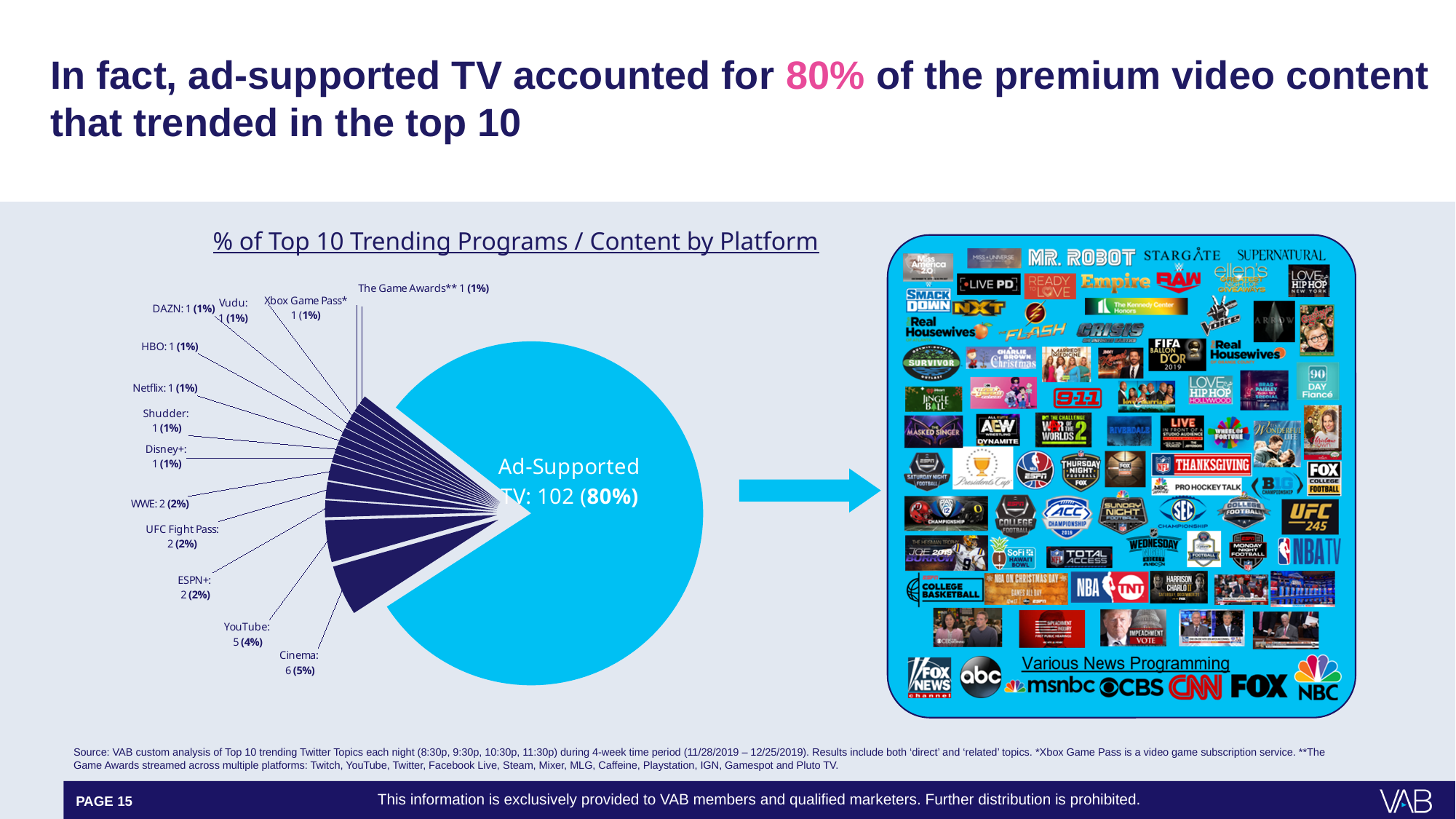
Which is larger, the value for Cinema or the value for YouTube? Cinema What percentage share is shown for ESPN+? 2% What is the value shown for YouTube? 5 (4%) What is the difference between the count for Ad-Supported TV and the count for Cinema? 96 How many platform categories are shown in the pie chart? 14 What kind of chart is shown on the slide? Pie chart What is the value shown for Netflix? 1 (1%) What is the title of the chart? % of Top 10 Trending Programs / Content by Platform How many trending programs are attributed to Ad-Supported TV in the chart? 102 What share of the pie does Ad-Supported TV account for? 80% What is the value shown for Cinema? 6 (5%) Which platform has the largest slice of the pie? Ad-Supported TV